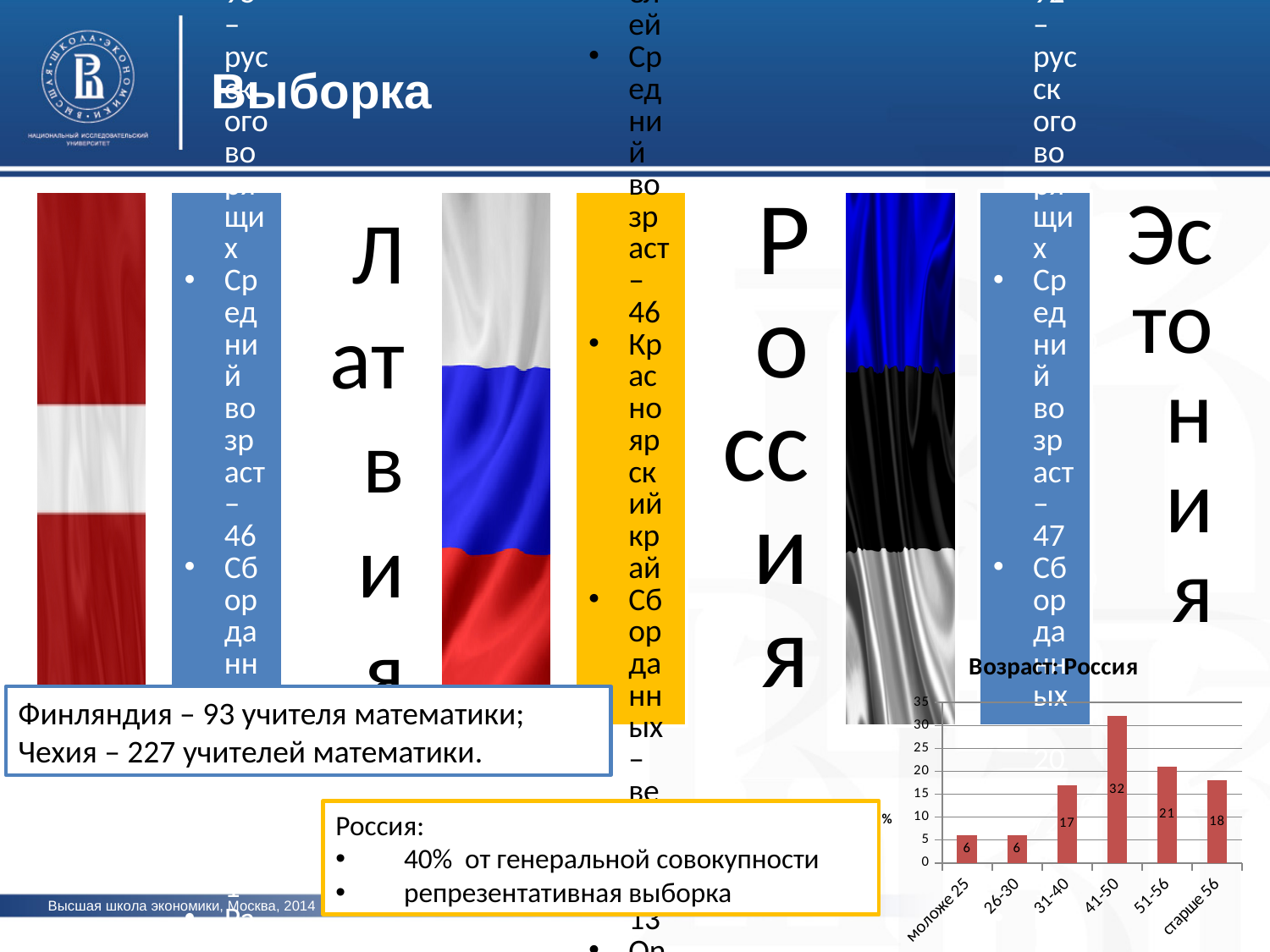
How many age groups are shown on the x axis of the "Возраст: Россия" chart? 6 In the "Возраст: Россия" chart, what is the value for the 41-50 age group? 32 In the "Возраст: Россия" chart, which age group has the highest value? 41-50 What kind of chart is shown under the title "Возраст: Россия"? bar chart In the "Возраст: Россия" chart, which is larger: the value for 31-40 or the value for "старше 56"? старше 56 In the "Возраст: Россия" chart, what is the difference between the values for 41-50 and 51-56? 11 In the "Возраст: Россия" chart, is the value for 41-50 greater or less than 30? greater In the "Возраст: Россия" chart, what is the value for the "моложе 25" group? 6 What is the title of the bar chart on the slide? Возраст: Россия In the "Возраст: Россия" chart, what is the value for the 31-40 age group? 17 In the "Возраст: Россия" chart, what is the value for the "старше 56" group? 18 In the "Возраст: Россия" chart, what is the value for the 51-56 age group? 21